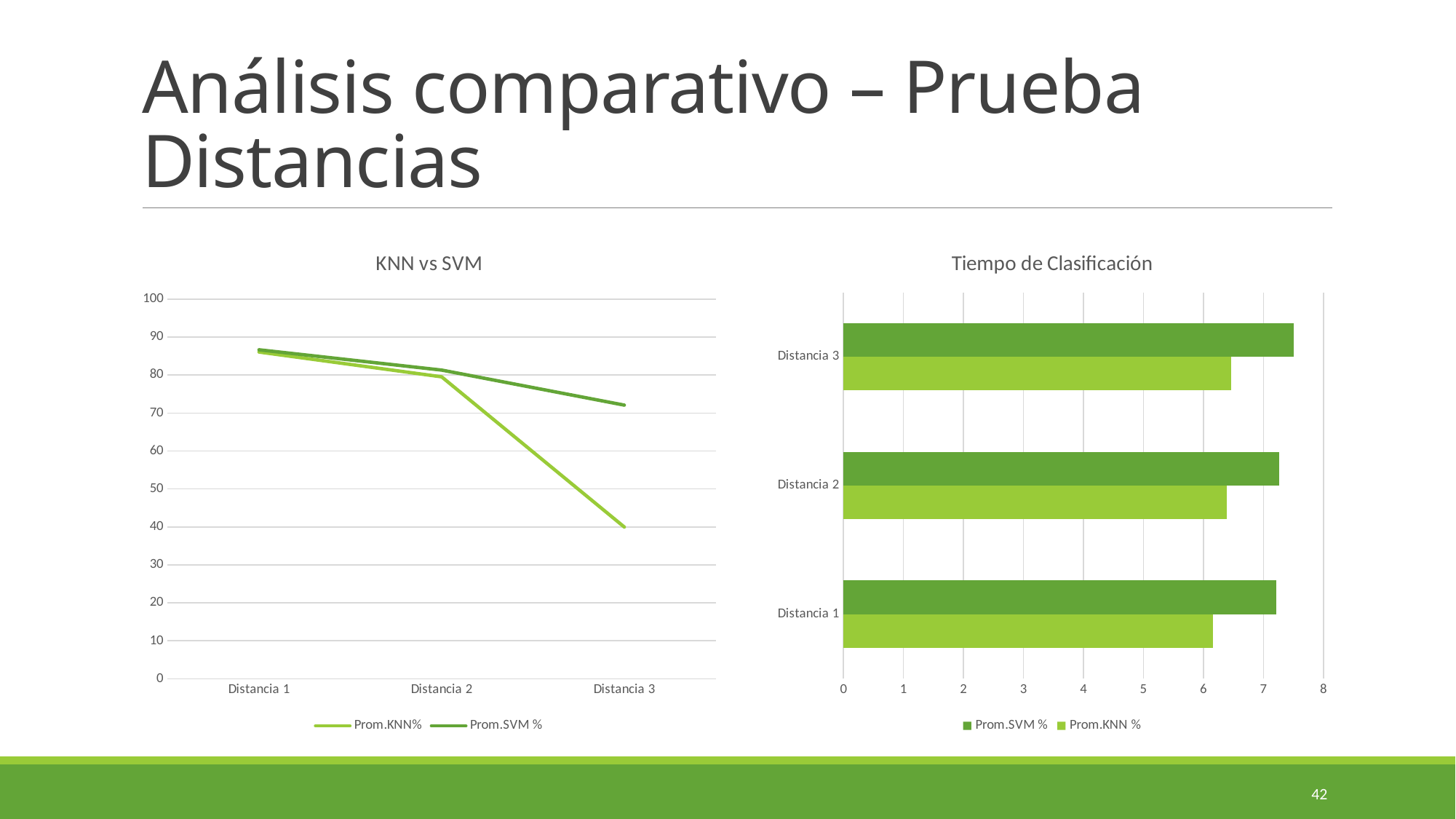
In the "KNN vs SVM" chart, does the Prom.KNN% line rise or fall from Distancia 1 to Distancia 3? fall In the "Tiempo de Clasificación" chart, is the Prom.KNN % value for Distancia 1 greater or less than 7? less What kind of chart is the "KNN vs SVM" chart? line chart How many series does the legend of the "KNN vs SVM" chart list? 2 In the "Tiempo de Clasificación" chart, which series has the larger value for Distancia 2, Prom.SVM % or Prom.KNN %? Prom.SVM % In the "KNN vs SVM" chart, which series has the larger value at Distancia 3, Prom.KNN% or Prom.SVM %? Prom.SVM % In the "KNN vs SVM" chart, is the Prom.SVM % value for Distancia 3 greater or less than 60? greater In the "Tiempo de Clasificación" chart, is the Prom.SVM % value for Distancia 3 greater or less than 7? greater How many categories are shown on the x axis of the "KNN vs SVM" chart? 3 What kind of chart is the "Tiempo de Clasificación" chart? bar chart What are the two legend entries of the "Tiempo de Clasificación" chart? Prom.SVM % and Prom.KNN %